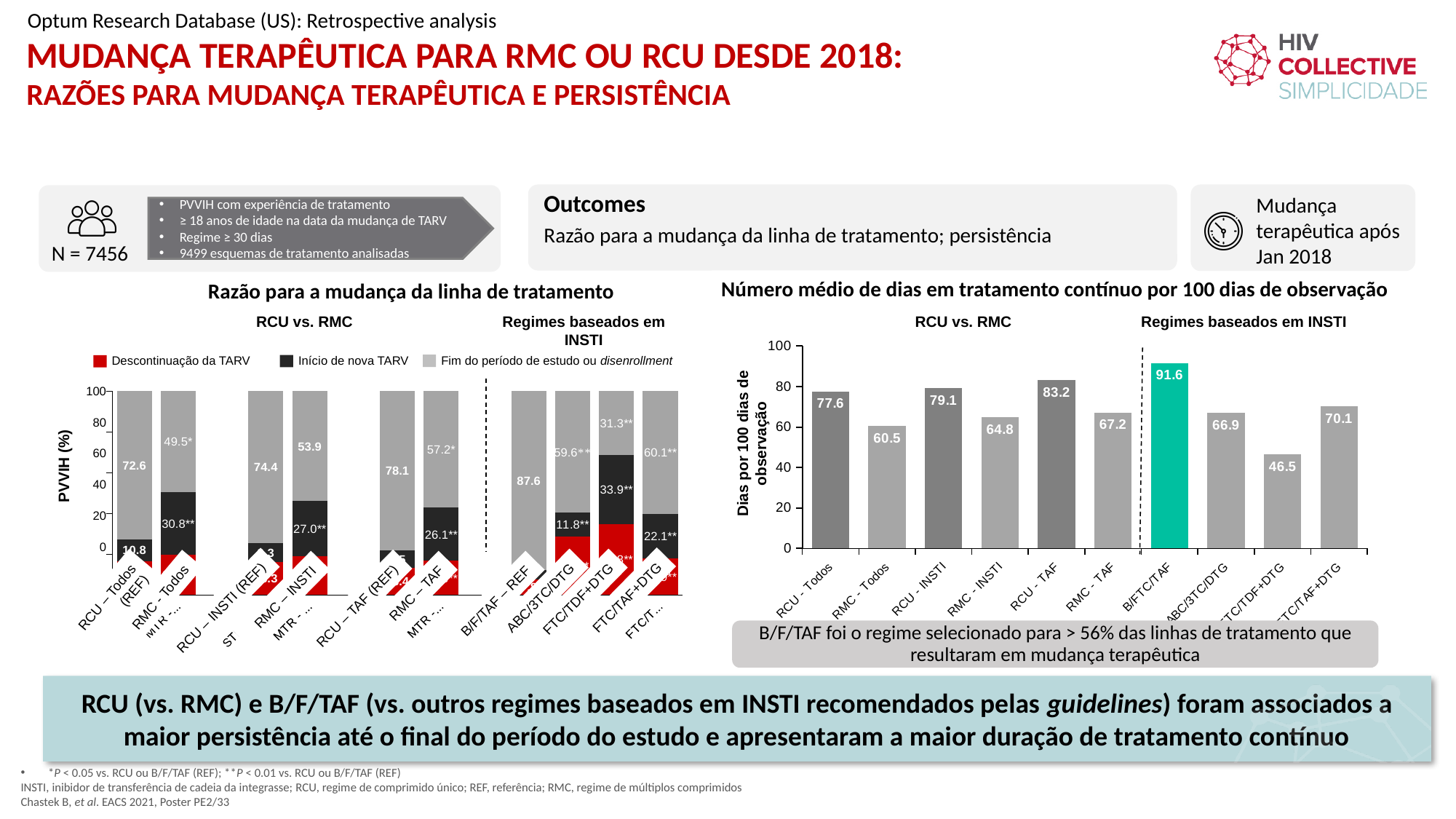
In the chart 'Razão para a mudança da linha de tratamento', what is the 'Fim do período de estudo ou disenrollment' value for B/F/TAF – REF? 87.6 In the chart 'Razão para a mudança da linha de tratamento', how many series does the legend list? 3 In the chart 'Número médio de dias em tratamento contínuo por 100 dias de observação', which is larger: RCU - INSTI or RMC - Todos? RCU - INSTI In the chart 'Número médio de dias em tratamento contínuo por 100 dias de observação', what is the value for RMC - INSTI? 64.8 In the chart 'Número médio de dias em tratamento contínuo por 100 dias de observação', which category has the highest value? B/FTC/TAF In the chart 'Razão para a mudança da linha de tratamento', what is the 'Início de nova TARV' value for RMC – Todos? 30.8** In the chart 'Número médio de dias em tratamento contínuo por 100 dias de observação', what is the value for RCU - Todos? 77.6 In the chart 'Número médio de dias em tratamento contínuo por 100 dias de observação', how many bars are plotted? 10 In the chart 'Número médio de dias em tratamento contínuo por 100 dias de observação', what is the lowest value shown? 46.5 In the chart 'Número médio de dias em tratamento contínuo por 100 dias de observação', what is the difference between RCU - TAF and RMC - TAF? 16.0 What kind of chart is 'Número médio de dias em tratamento contínuo por 100 dias de observação'? Bar chart In the chart 'Número médio de dias em tratamento contínuo por 100 dias de observação', what is the value for B/F/TC/TAF? 91.6